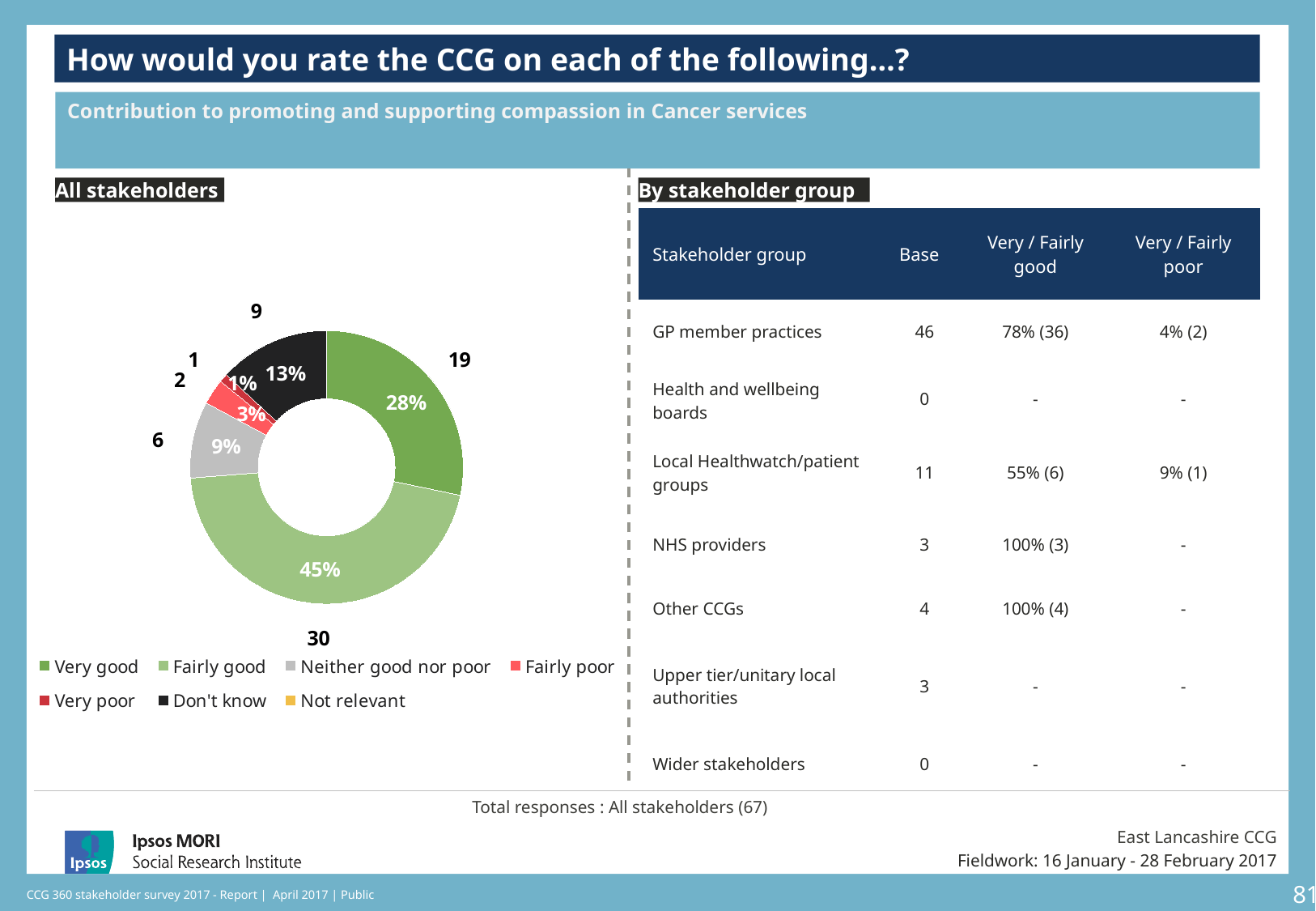
In the 'All stakeholders' chart, what percentage of respondents rated the CCG 'Fairly good'? 45% In the 'All stakeholders' chart, what percentage answered 'Don't know'? 13% How many entries does the legend of the 'All stakeholders' chart list? 7 In the 'All stakeholders' chart, what percentage of respondents rated the CCG 'Very good'? 28% In the 'All stakeholders' chart, what is the difference in percentage points between 'Fairly good' and 'Very good'? 17 percentage points In the 'All stakeholders' chart, which rating category has the largest share? Fairly good In the 'All stakeholders' chart, which is larger: the share for 'Don't know' or the share for 'Neither good nor poor'? Don't know What kind of chart is shown under 'All stakeholders'? Doughnut (pie) chart In the 'All stakeholders' chart, what colour represents 'Don't know'? Black In the 'All stakeholders' chart, how many respondents rated the CCG 'Neither good nor poor'? 6 In the 'All stakeholders' chart, how many respondents rated the CCG 'Fairly poor'? 2 In the 'All stakeholders' chart, which labelled rating category has the smallest share? Very poor